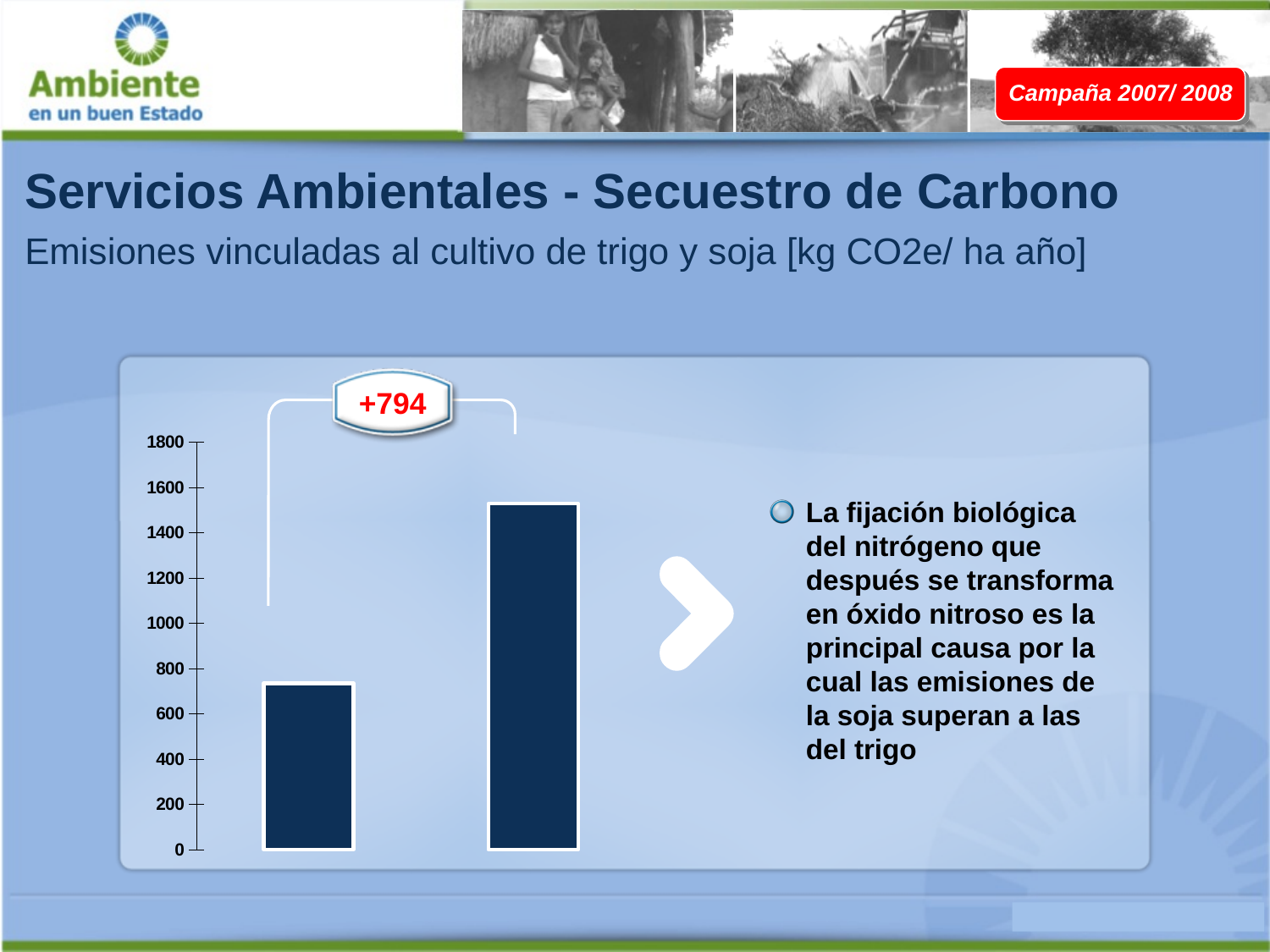
Is the value of the left bar greater or less than 800? less Is the value of the right bar greater or less than 1600? less Is the value of the left bar greater or less than 600? greater What difference between the two bars is printed in the callout above the chart? +794 How many bars are plotted in the chart? 2 Which bar is taller, the left bar or the right bar? the right bar What unit is given for the emissions in the chart's subtitle? kg CO2e/ ha año What kind of chart is shown on the slide? bar chart What is the highest value shown on the vertical axis? 1800 Do the bar values rise or fall from left to right? rise